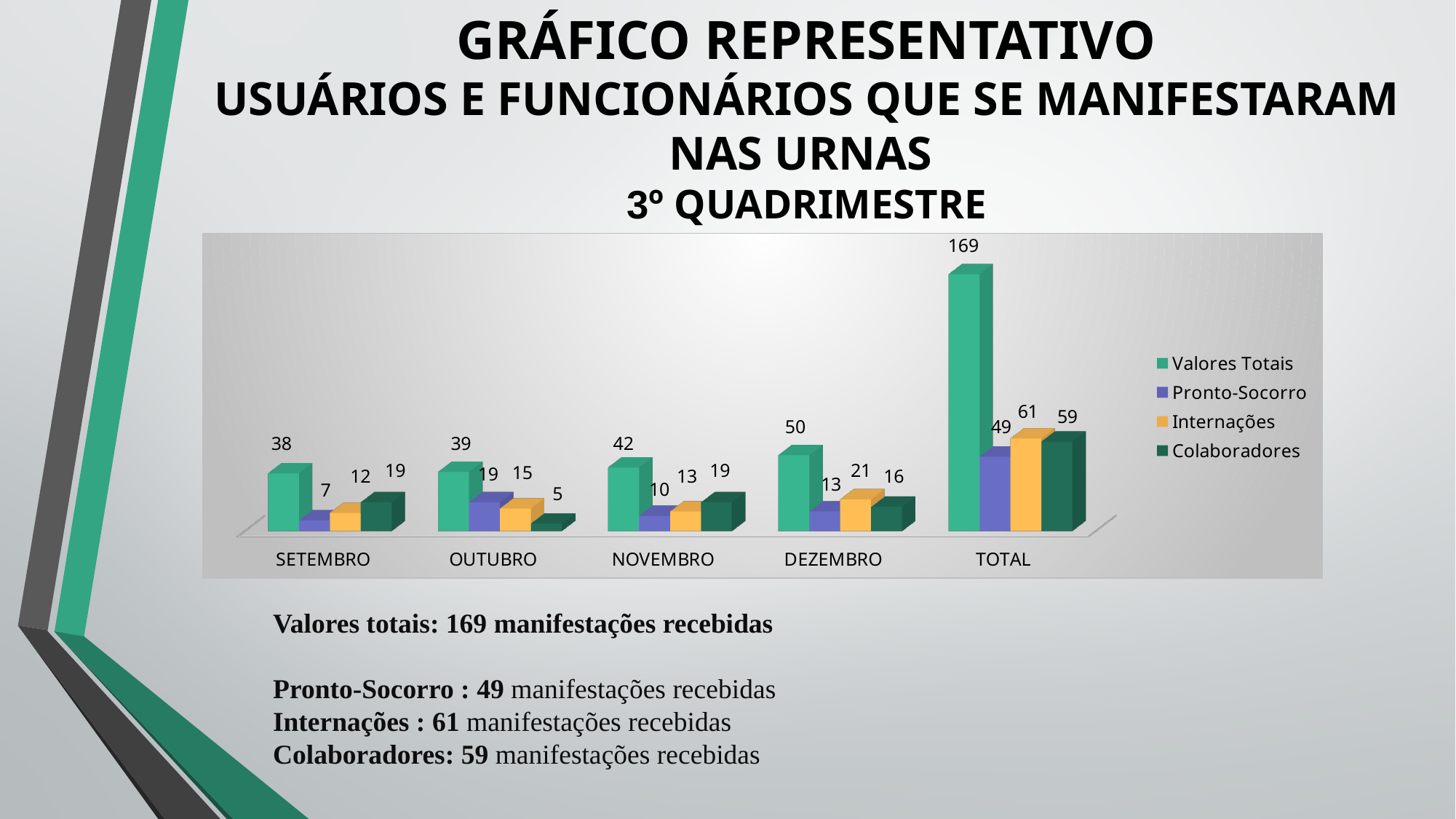
Do the Valores Totais values rise or fall from SETEMBRO to DEZEMBRO? Rise Which is larger: the Pronto-Socorro value for SETEMBRO or for NOVEMBRO? NOVEMBRO What is the value of Colaboradores for SETEMBRO? 19 What is the value of Internações for TOTAL? 61 What kind of chart is shown on the slide? Bar chart How many categories are shown on the x axis? 5 Which month (excluding TOTAL) has the highest Valores Totais value? DEZEMBRO Which category has the lowest Colaboradores value? OUTUBRO What is the difference between the Internações value for DEZEMBRO and for NOVEMBRO? 8 What is the value of Pronto-Socorro for OUTUBRO? 19 How many series does the legend list? 4 What is the value of Valores Totais for DEZEMBRO? 50